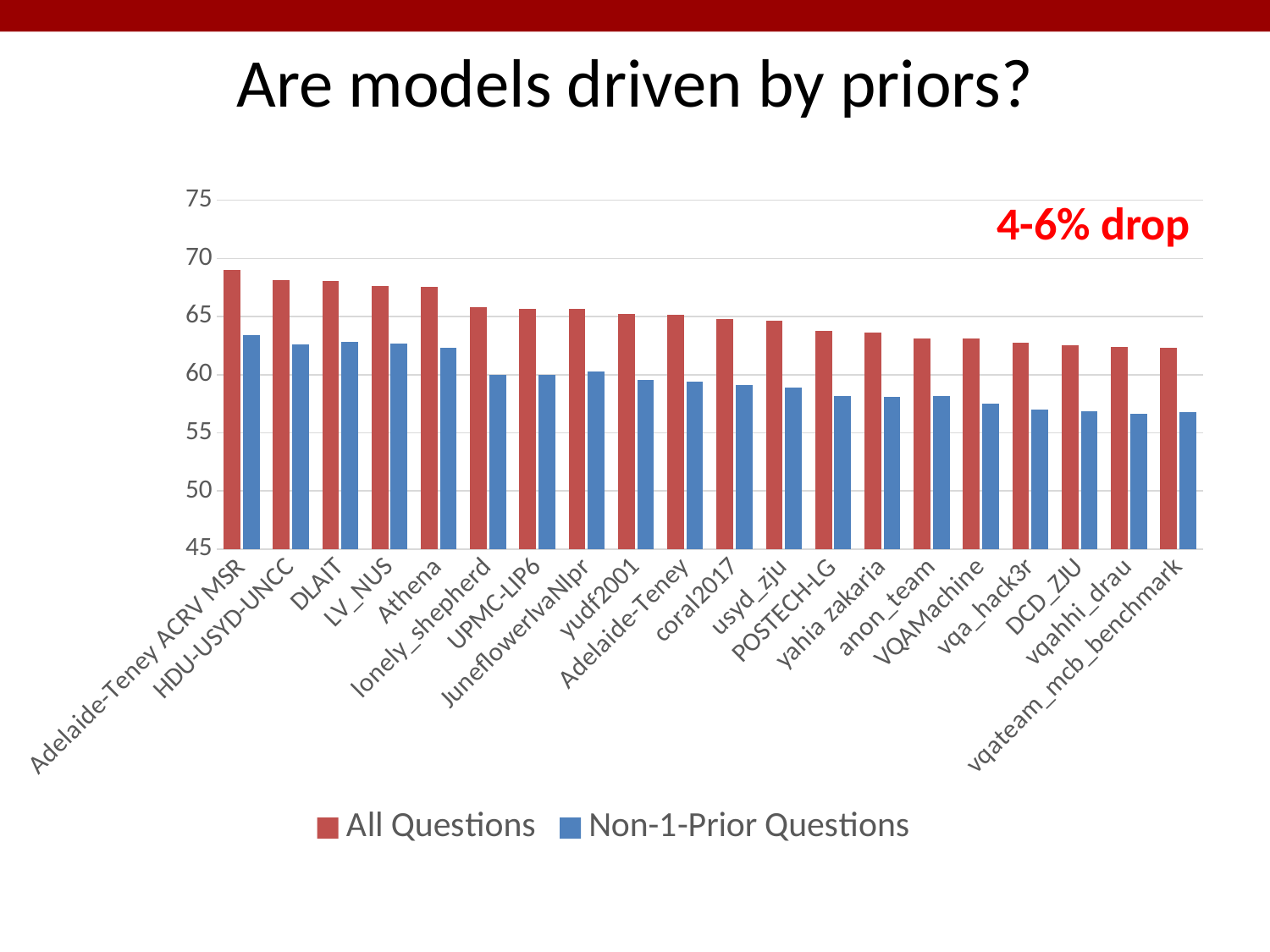
How many teams (categories) are shown on the x axis? 20 Do the All Questions values rise or fall from left to right along the x axis? fall How many series does the legend list? 2 Is the All Questions value for POSTECH-LG greater or less than 65? less What kind of chart is shown on the slide? bar chart Is the All Questions value for Adelaide-Teney ACRV MSR greater or less than 65? greater Is the Non-1-Prior Questions value for DLAIT greater or less than 60? greater What colour are the bars for the Non-1-Prior Questions series? blue Which team has the highest value for All Questions? Adelaide-Teney ACRV MSR For yudf2001, which is larger: the All Questions value or the Non-1-Prior Questions value? All Questions